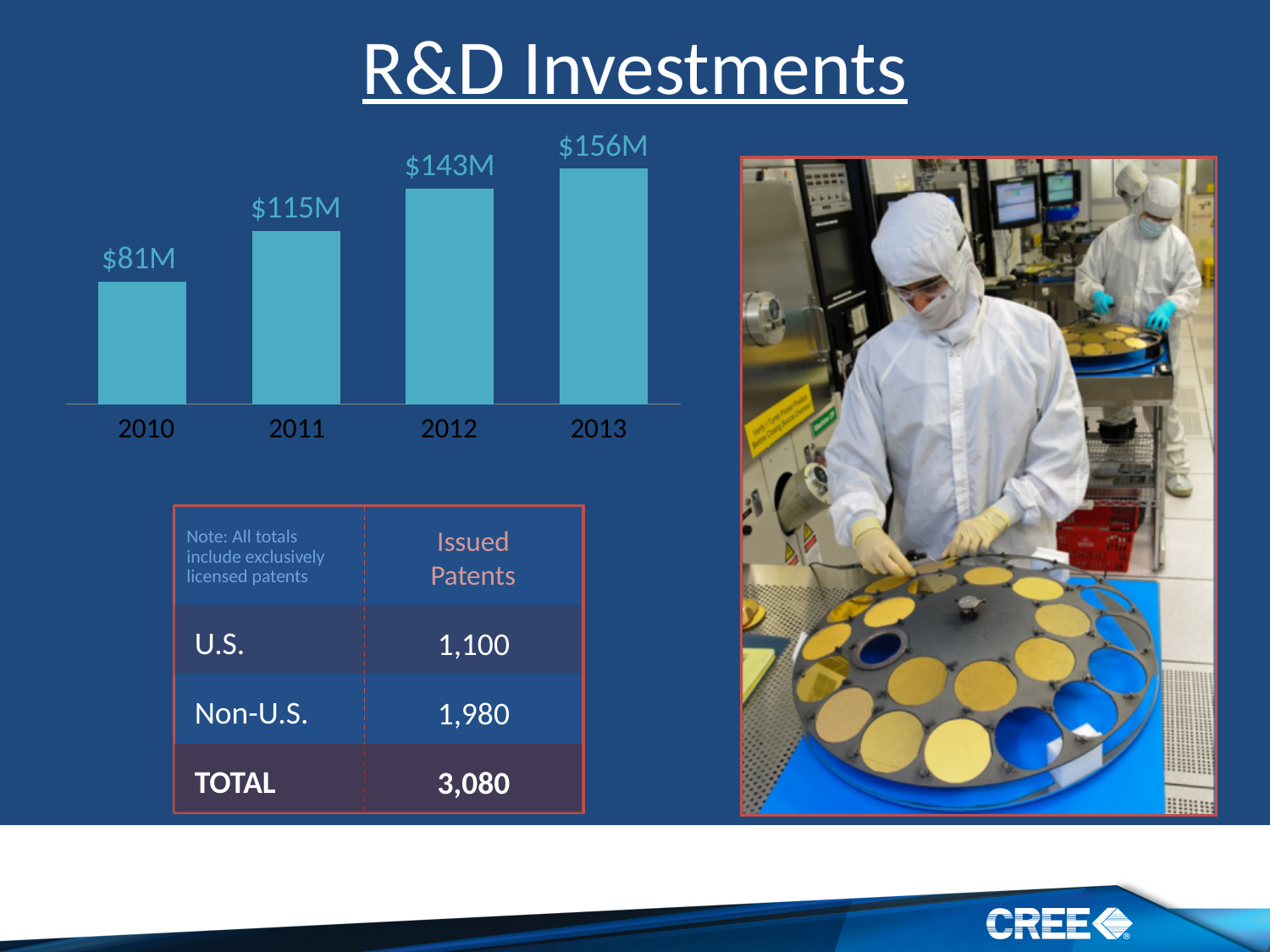
What type of chart is used to show R&D Investments? Bar chart Which year had the highest R&D investment? 2013 What is the difference between the R&D investment in 2013 and in 2010? $75M What was the R&D investment in 2013? $156M What was the R&D investment in 2012? $143M Which year had a larger R&D investment, 2011 or 2012? 2012 What is the difference between the R&D investment in 2012 and in 2011? $28M How many years are shown in the R&D Investments chart? 4 Do R&D investments rise or fall from 2010 to 2013? Rise Which year had the lowest R&D investment? 2010 What was the R&D investment in 2010? $81M What was the R&D investment in 2011? $115M